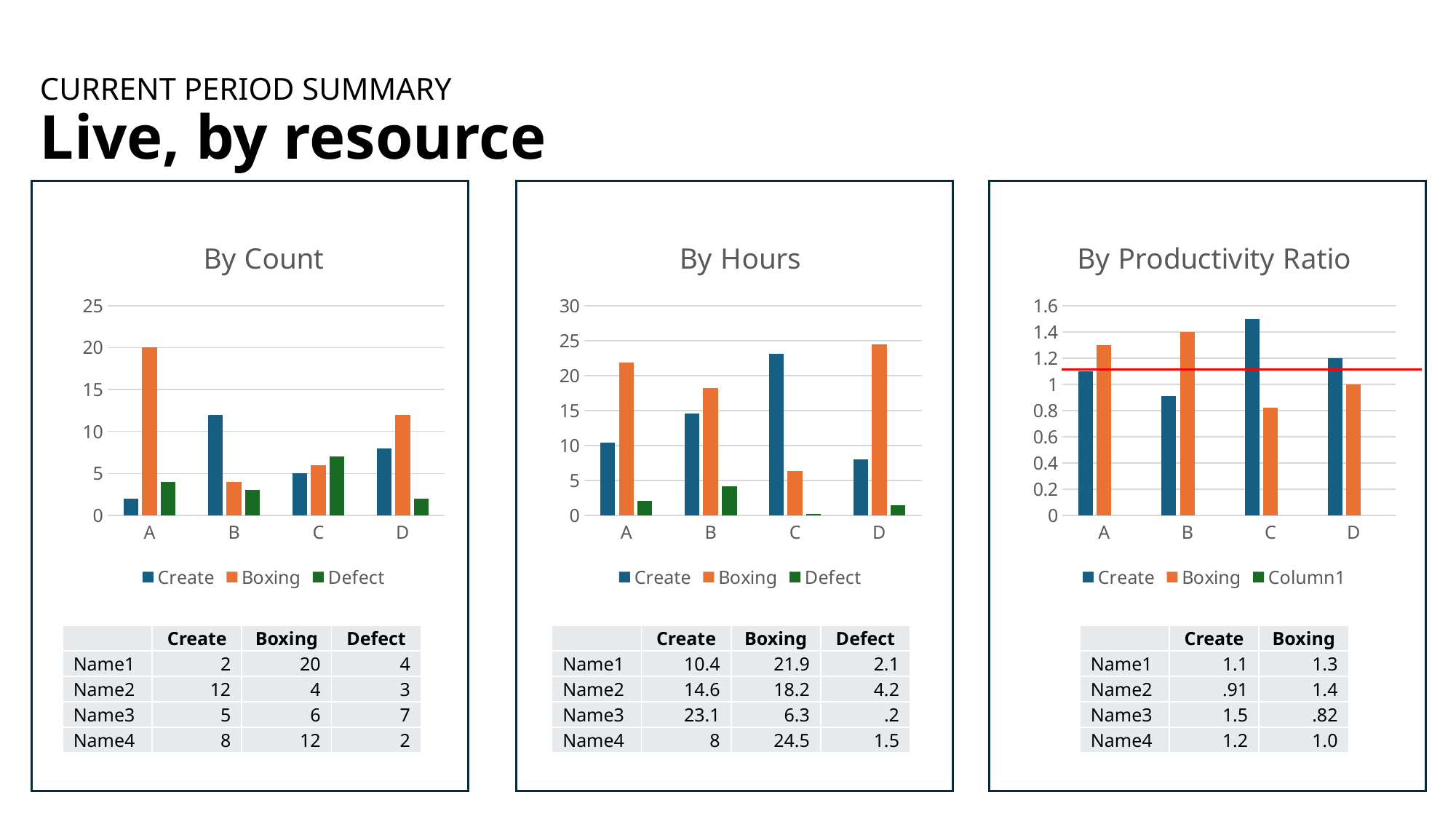
In the 'By Hours' chart, which category has the highest Create value? C In the 'By Count' chart, what is the Boxing value for category A? 20 In the 'By Productivity Ratio' chart, what is the Create value for category D? 1.2 In the 'By Hours' chart, which is larger for category D, Create or Boxing? Boxing In the 'By Hours' chart, how many categories are shown on the x axis? 4 In the 'By Count' chart, is the Create value for category B greater or less than 10? greater In the 'By Productivity Ratio' chart, which category has the lowest Boxing value? C In the 'By Count' chart, how many series does the legend list? 3 In the 'By Count' chart, which category has the highest Boxing value? A In the 'By Hours' chart, is the Boxing value for category C greater or less than 10? less What kind of chart is the 'By Count' chart? bar chart In the 'By Productivity Ratio' chart, what is the third entry in the legend? Column1